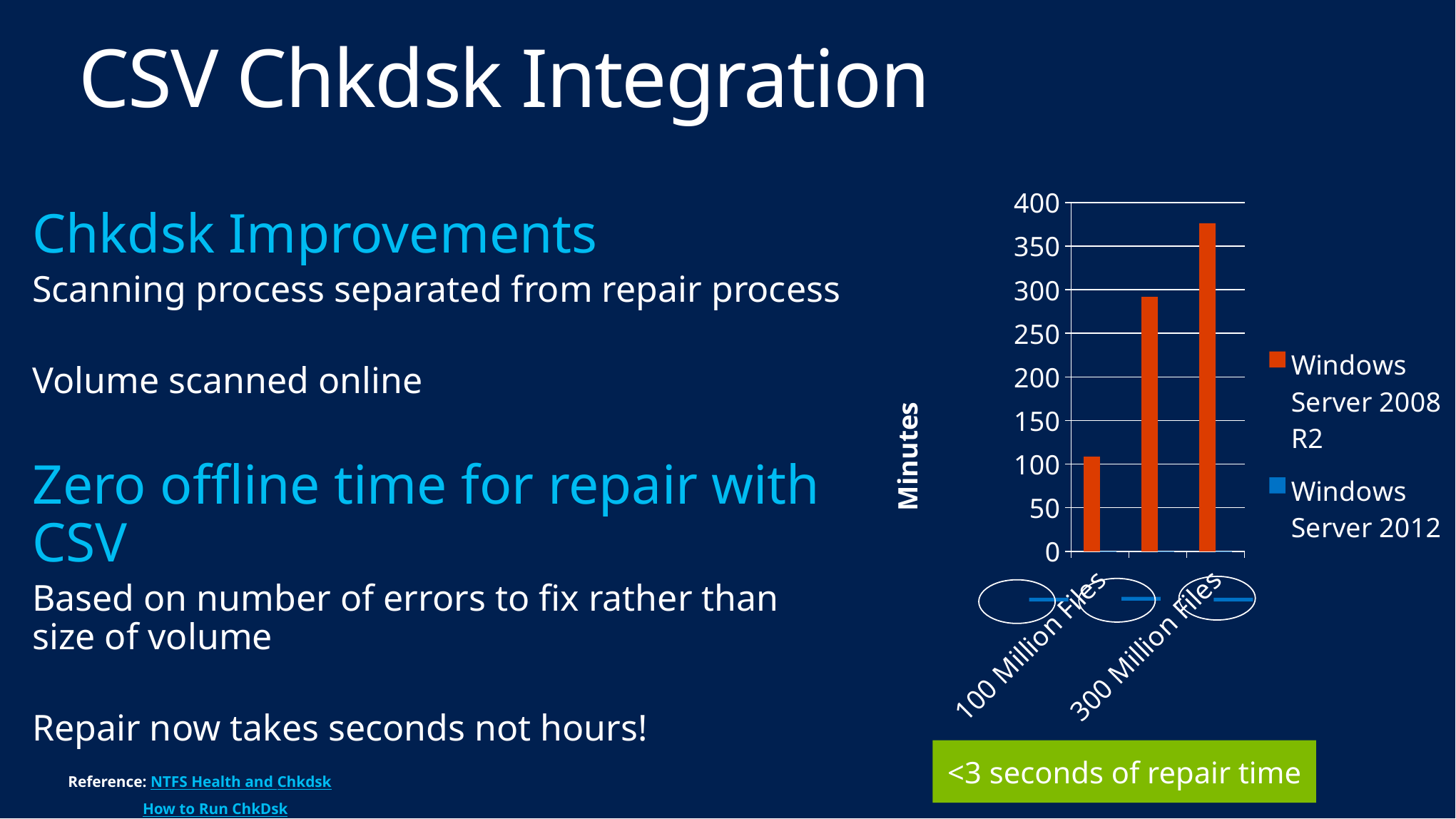
How many series does the chart legend list? 2 Do the Windows Server 2008 R2 values rise or fall as the number of files increases along the x axis? rise For 100 Million Files, which series has the larger value, Windows Server 2008 R2 or Windows Server 2012? Windows Server 2008 R2 What kind of chart is shown on the slide? bar chart What are the two series named in the chart legend? Windows Server 2008 R2 and Windows Server 2012 What is the label on the chart's vertical axis? Minutes Which series has the lowest values in the chart? Windows Server 2012 Is the Windows Server 2008 R2 value for 300 Million Files greater or less than 250? greater Is the Windows Server 2008 R2 value for 100 Million Files greater or less than 150? less Which series has the higher values across all categories in the chart? Windows Server 2008 R2 Is the Windows Server 2008 R2 value for 300 Million Files greater or less than 400? less